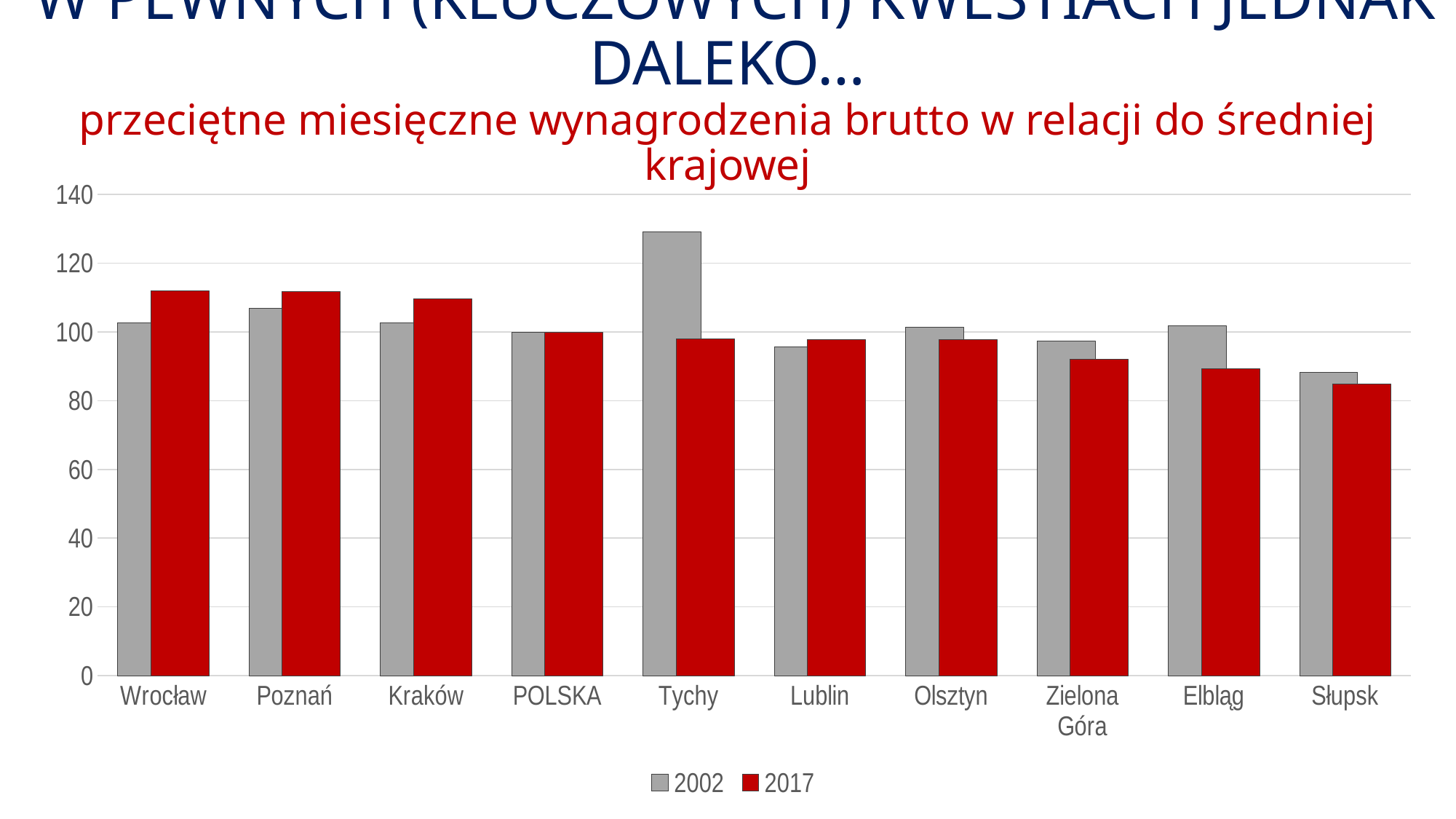
For Wrocław, which is larger: the 2002 value or the 2017 value? 2017 Which colour represents the 2017 series in the legend? red Which category has the highest value for 2002? Tychy Is the value for Tychy in 2002 greater or less than 120? greater Is the value for Słupsk in 2017 greater or less than 100? less What is the value for POLSKA in 2017? 100 What kind of chart is shown on the slide? bar chart How many series does the legend list? 2 Which category has the lowest value for 2002? Słupsk How many categories (cities plus POLSKA) are shown on the x axis? 10 For Tychy, which is larger: the 2002 value or the 2017 value? 2002 Which category has the lowest value for 2017? Słupsk